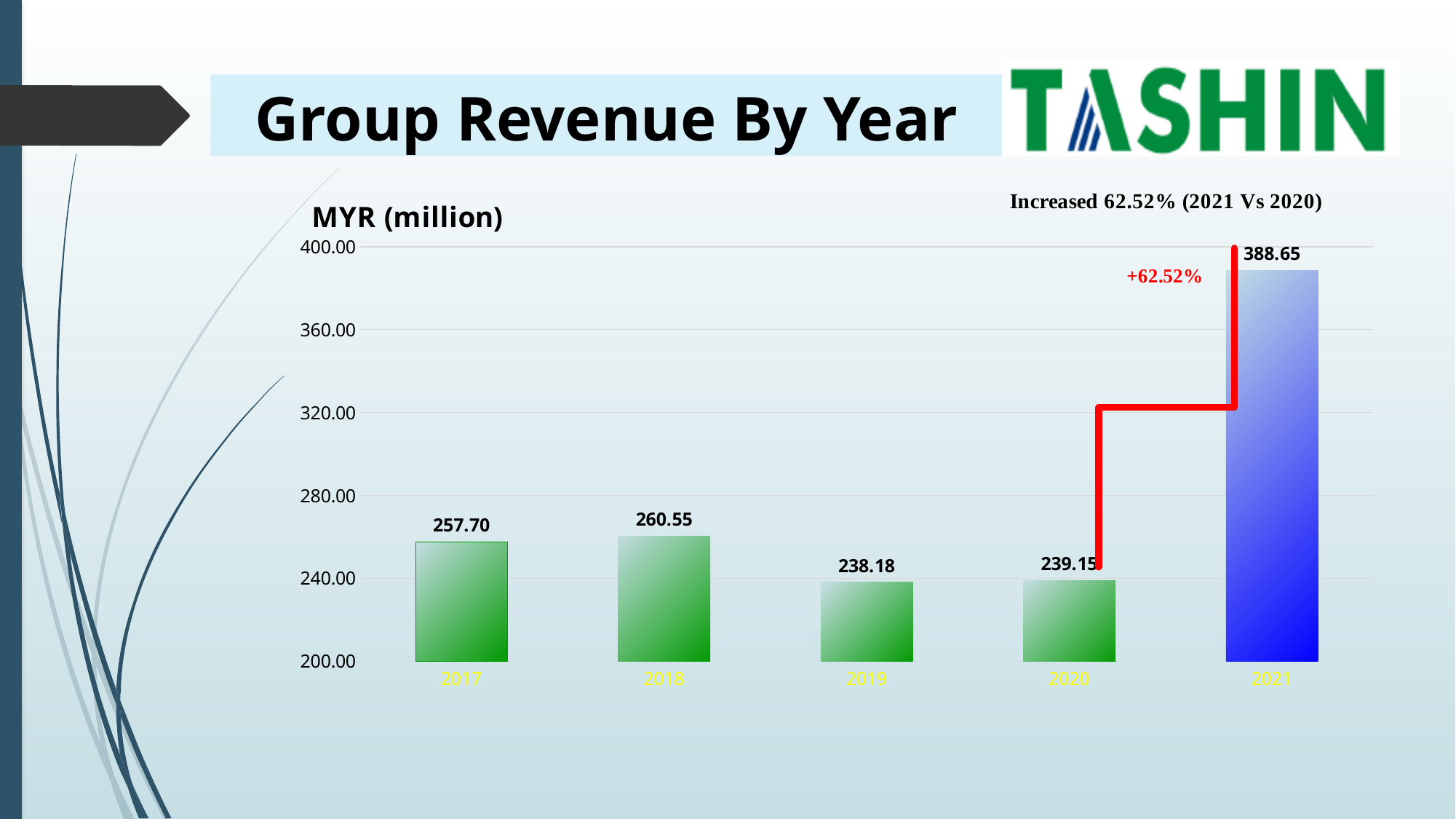
Is the group revenue for 2021 greater or less than 360.00? greater What percentage increase in revenue is annotated between 2020 and 2021? +62.52% What was the group revenue in 2021? 388.65 What was the group revenue in 2017? 257.70 Which year had the highest group revenue? 2021 What was the group revenue in 2019? 238.18 Which year had higher group revenue, 2017 or 2019? 2017 What is the difference in group revenue between 2018 and 2017? 2.85 What kind of chart is used to show group revenue by year? bar chart How many years are shown in the chart? 5 Which year had the lowest group revenue? 2019 What is the difference in group revenue between 2021 and 2020? 149.50